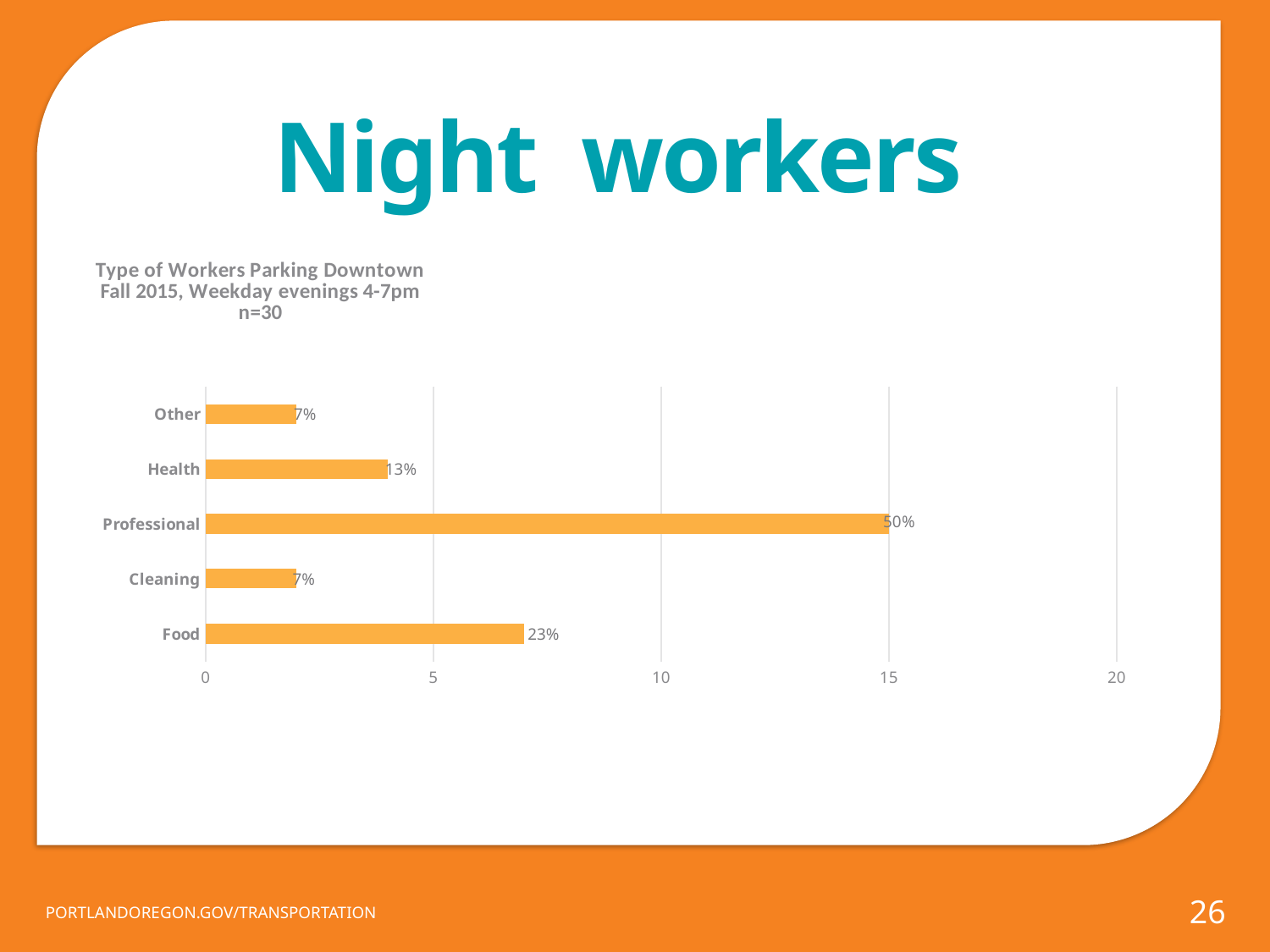
Which has a larger value, Health or Food? Food What is the data label shown for Cleaning? 7% What kind of chart is shown on the slide? Bar chart What is the data label shown for Health? 13% Is the bar for Health greater or less than 5 on the axis? less Which type of worker has the highest value? Professional What is the data label shown for Professional? 50% What sample size (n) is stated in the chart title? n=30 Is the bar for Professional greater or less than 10 on the axis? greater How many worker categories are shown in the chart? 5 What is the data label shown for Food? 23% What is the difference between the labelled values for Professional and Food? 27%